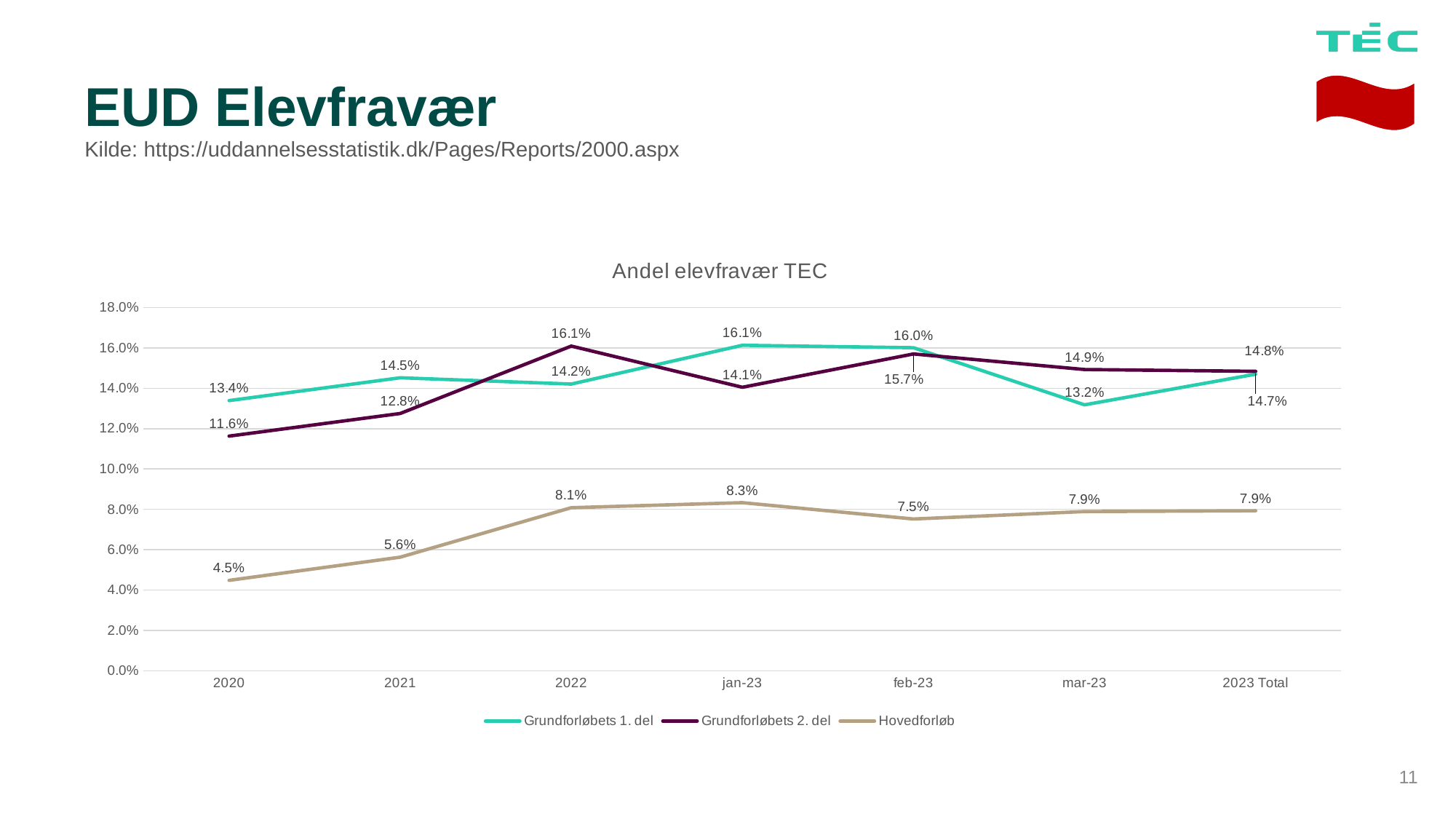
What is the title of the chart? Andel elevfravær TEC In which period is Hovedforløb highest? jan-23 How many series does the legend list? 3 What is the value for Grundforløbets 2. del at 2023 Total? 14.8% What is the value for Hovedforløb in 2020? 4.5% How many periods are shown on the x axis? 7 What is the value for Grundforløbets 2. del in 2022? 16.1% What kind of chart is shown? Line chart In which period is Grundforløbets 2. del lowest? 2020 What is the value for Grundforløbets 1. del in mar-23? 13.2% Which is larger in 2021: Grundforløbets 1. del or Grundforløbets 2. del? Grundforløbets 1. del What is the difference between Grundforløbets 1. del and Hovedforløb in 2020? 8.9 percentage points